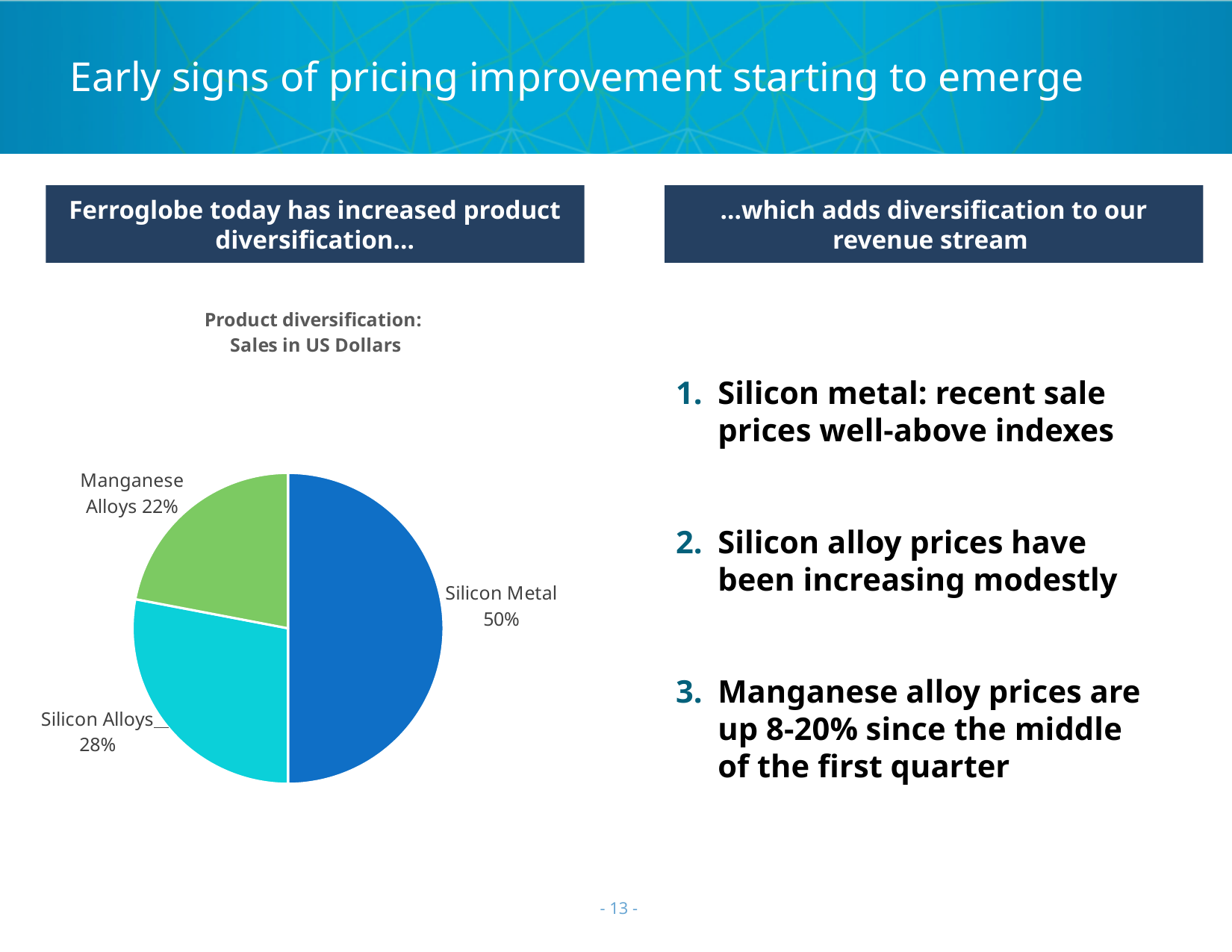
Which has a larger share of sales, Silicon Alloys or Manganese Alloys? Silicon Alloys What colour is the Silicon Metal slice in the pie chart? Blue Which product category has the largest share of sales in the pie chart? Silicon Metal What is the difference in share between Silicon Metal and Silicon Alloys? 22 percentage points What share of sales does Manganese Alloys account for in the pie chart? 22% What is the title of the pie chart? Product diversification: Sales in US Dollars What kind of chart is used to show product diversification? Pie chart What is the difference in share between Silicon Alloys and Manganese Alloys? 6 percentage points What share of sales does Silicon Alloys account for in the pie chart? 28% Which product category has the smallest share of sales in the pie chart? Manganese Alloys What share of sales does Silicon Metal account for in the pie chart? 50% How many product categories are shown in the pie chart? 3